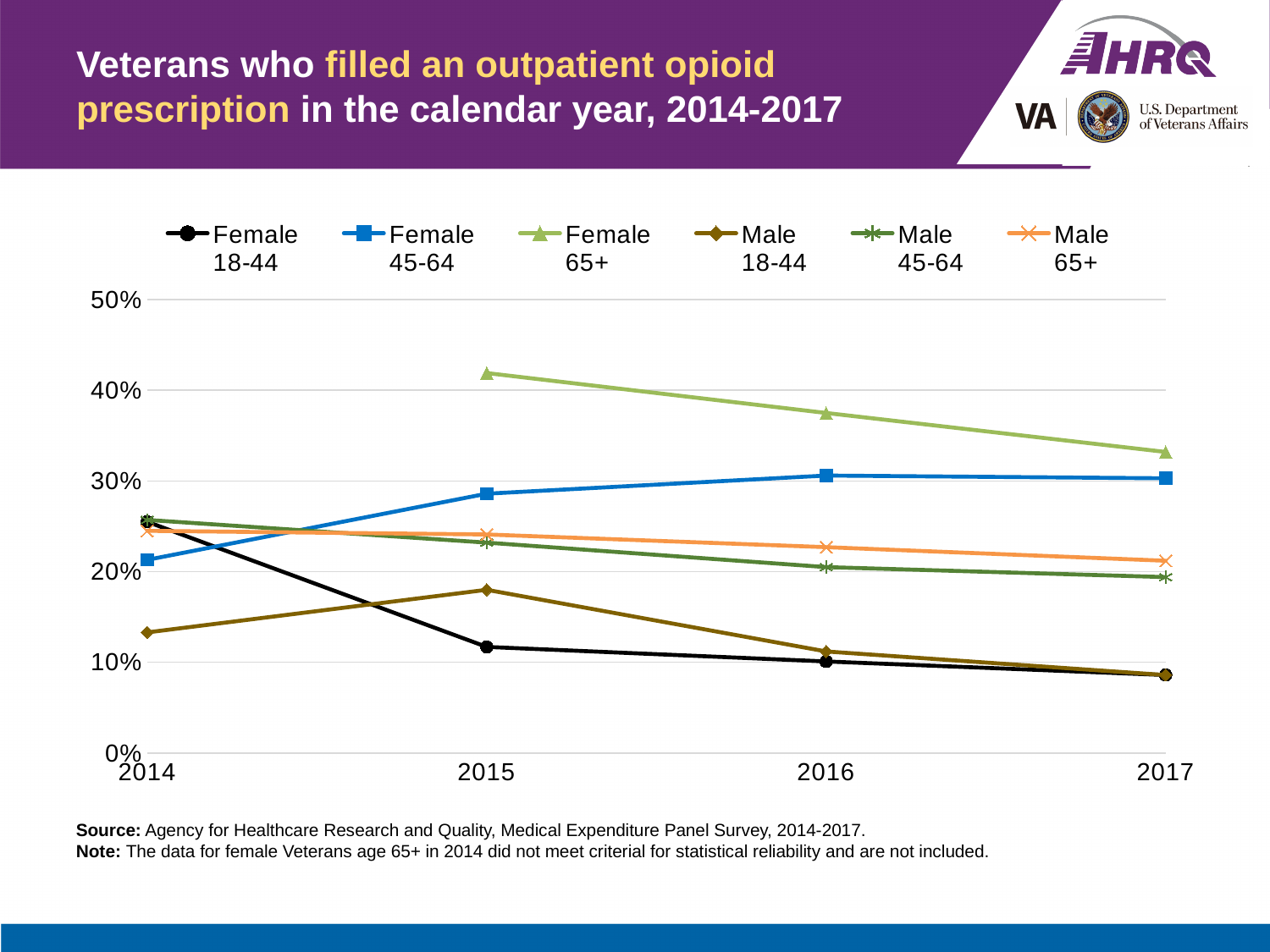
Which series has the highest value in 2016? Female 65+ Is the value for Male 18-44 in 2015 greater or less than 20%? less Does the Female 65+ line rise or fall from 2015 to 2017? fall In 2017, which is larger: the value for Female 45-64 or Male 45-64? Female 45-64 How many series does the legend list? 6 Is the value for Female 65+ in 2015 greater or less than 40%? greater Is the value for Female 18-44 in 2017 greater or less than 10%? less What kind of chart is shown on the slide? line chart Does the Female 45-64 line rise or fall from 2014 to 2016? rise Which series has no data point plotted for 2014? Female 65+ Which series has the lowest value in 2014? Male 18-44 How many years are shown on the x axis? 4